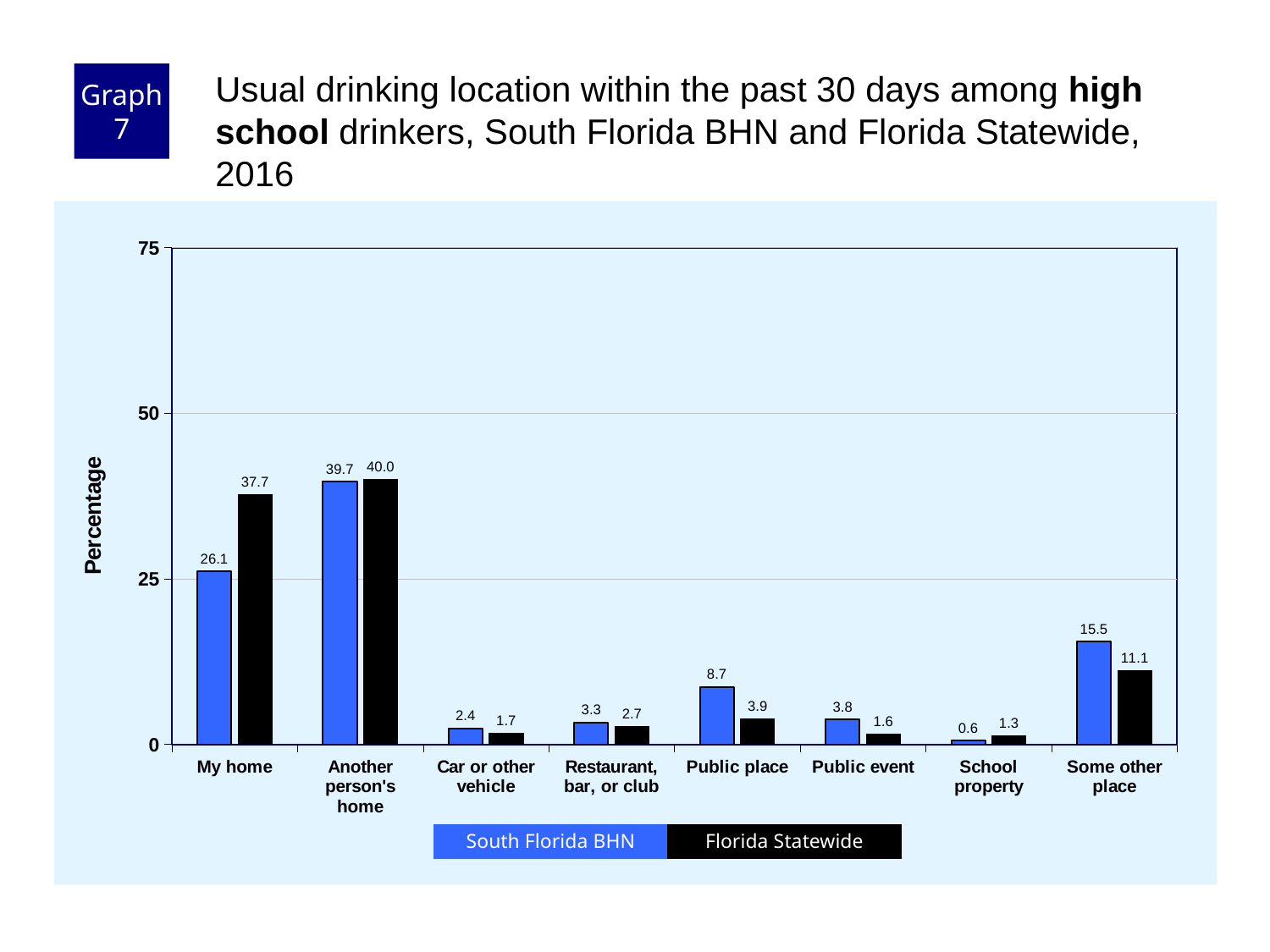
What is the South Florida BHN value for Public place? 8.7 Which category has the lowest South Florida BHN value? School property Is the Florida Statewide value for Another person's home greater or less than 25? greater How many series does the legend list? 2 What is the South Florida BHN value for My home? 26.1 What is the label of the y axis? Percentage Which category has the highest Florida Statewide value? Another person's home How many drinking location categories are shown on the x axis? 8 Which is larger for Public event: South Florida BHN or Florida Statewide? South Florida BHN What kind of chart is shown on the slide? bar chart What is the Florida Statewide value for Some other place? 11.1 What is the difference between the Florida Statewide and South Florida BHN values for My home? 11.6